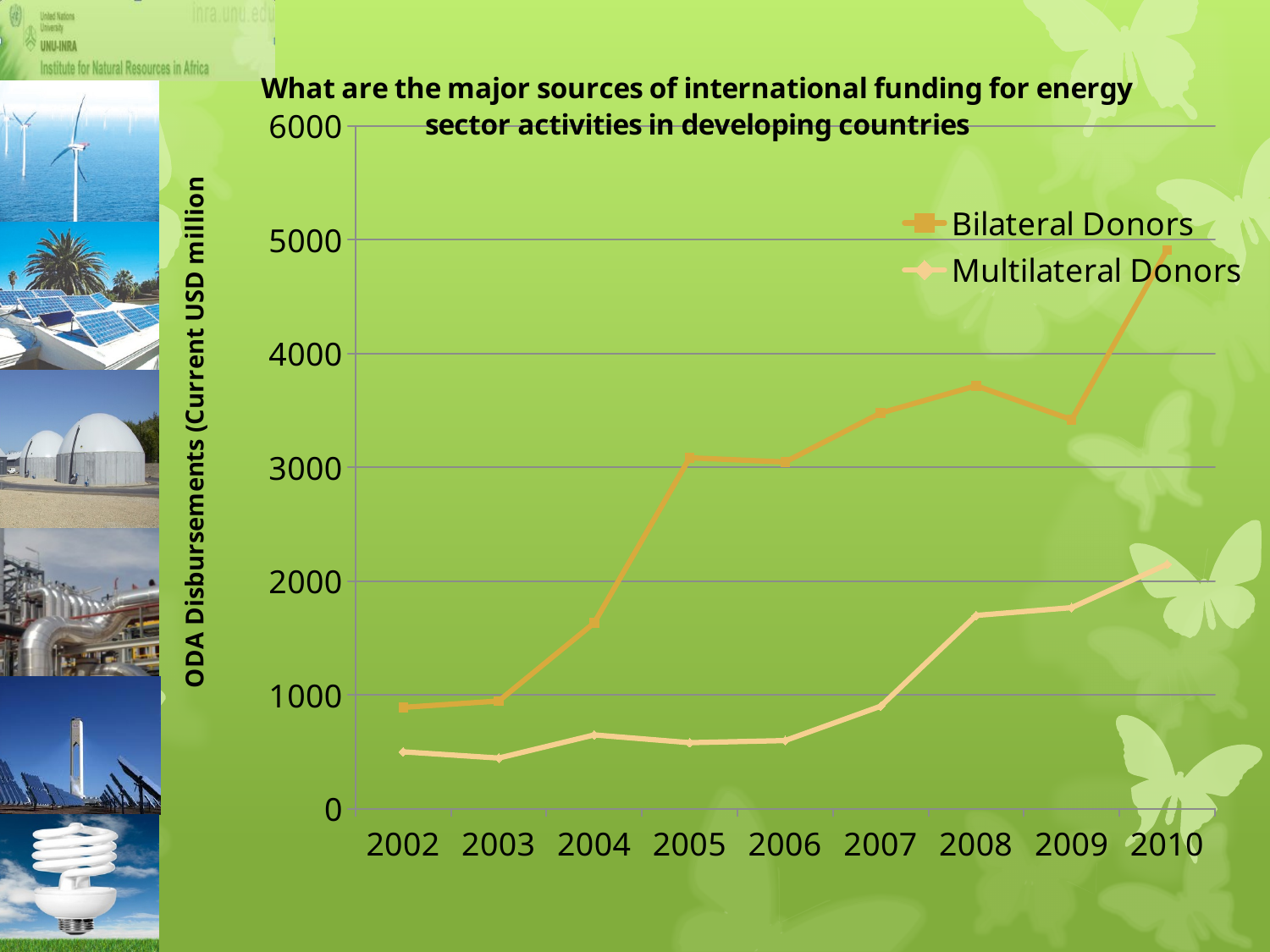
Is the value for Bilateral Donors in 2010 greater or less than 4000? greater What kind of chart is shown on the slide? line chart Is the value for Bilateral Donors in 2005 greater or less than 3000? greater Is the value for Multilateral Donors in 2010 greater or less than 2000? greater In which year is the value for Multilateral Donors highest? 2010 How many years are shown on the x axis? 9 Which series has the larger value in 2008, Bilateral Donors or Multilateral Donors? Bilateral Donors How many series does the legend list? 2 What is the label on the y axis? ODA Disbursements (Current USD million In which year is the value for Bilateral Donors highest? 2010 Do the values for Multilateral Donors generally rise or fall from 2006 to 2010? rise